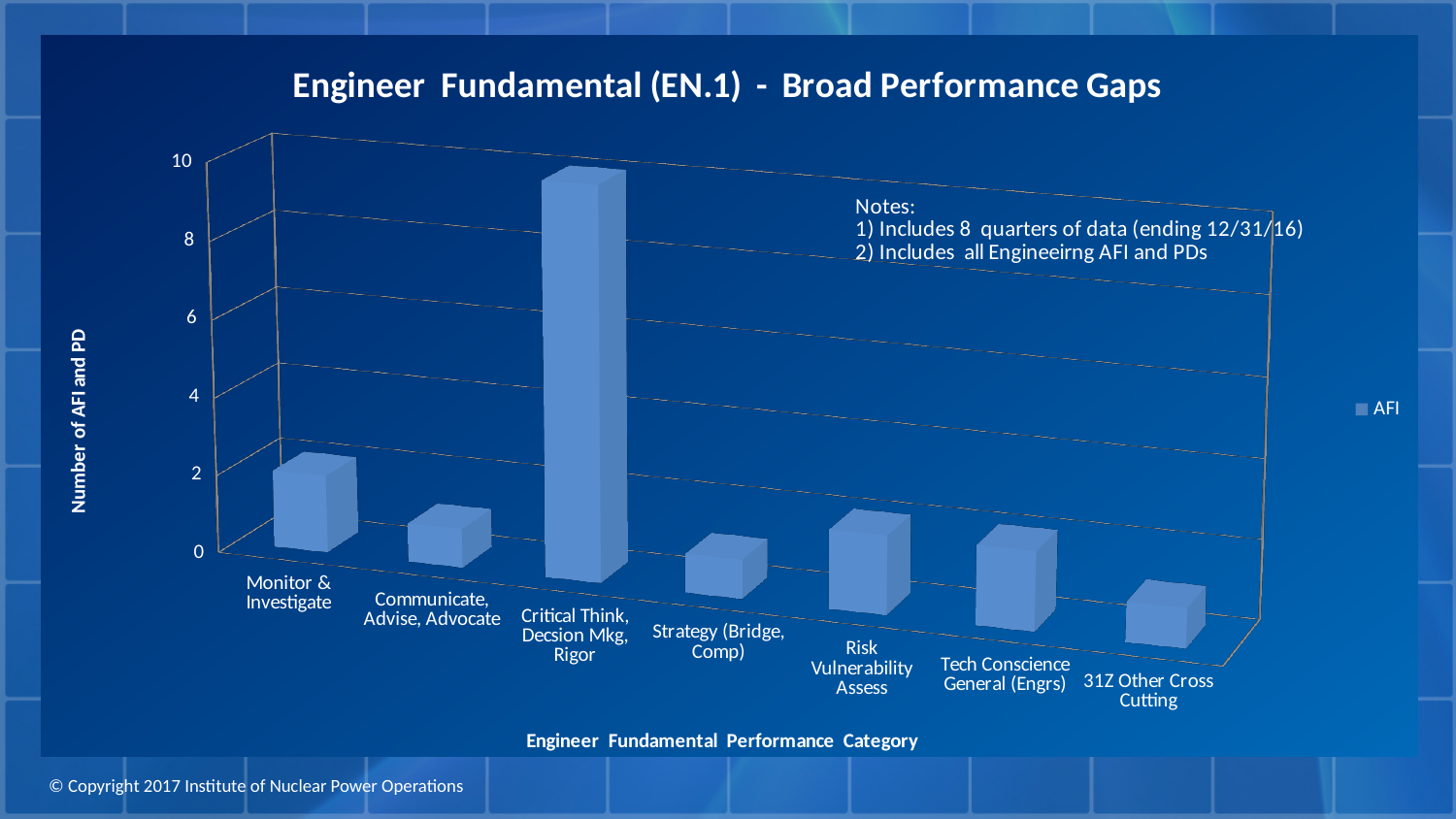
What type of chart is shown on the slide? Bar chart What is the title of the chart? Engineer Fundamental (EN.1) - Broad Performance Gaps Is the value for Tech Conscience General (Engrs) greater or less than 6? less Which is larger, the value for Monitor & Investigate or the value for Critical Think, Decsion Mkg, Rigor? Critical Think, Decsion Mkg, Rigor Which is larger, the value for Critical Think, Decsion Mkg, Rigor or the value for Strategy (Bridge, Comp)? Critical Think, Decsion Mkg, Rigor Which category has the highest number of AFI and PD? Critical Think, Decsion Mkg, Rigor How many categories are shown on the x axis of the chart? 7 How many series does the legend list? 1 Is the value for Critical Think, Decsion Mkg, Rigor greater or less than 8? greater What is the label of the vertical axis? Number of AFI and PD Is the value for Monitor & Investigate greater or less than 4? less